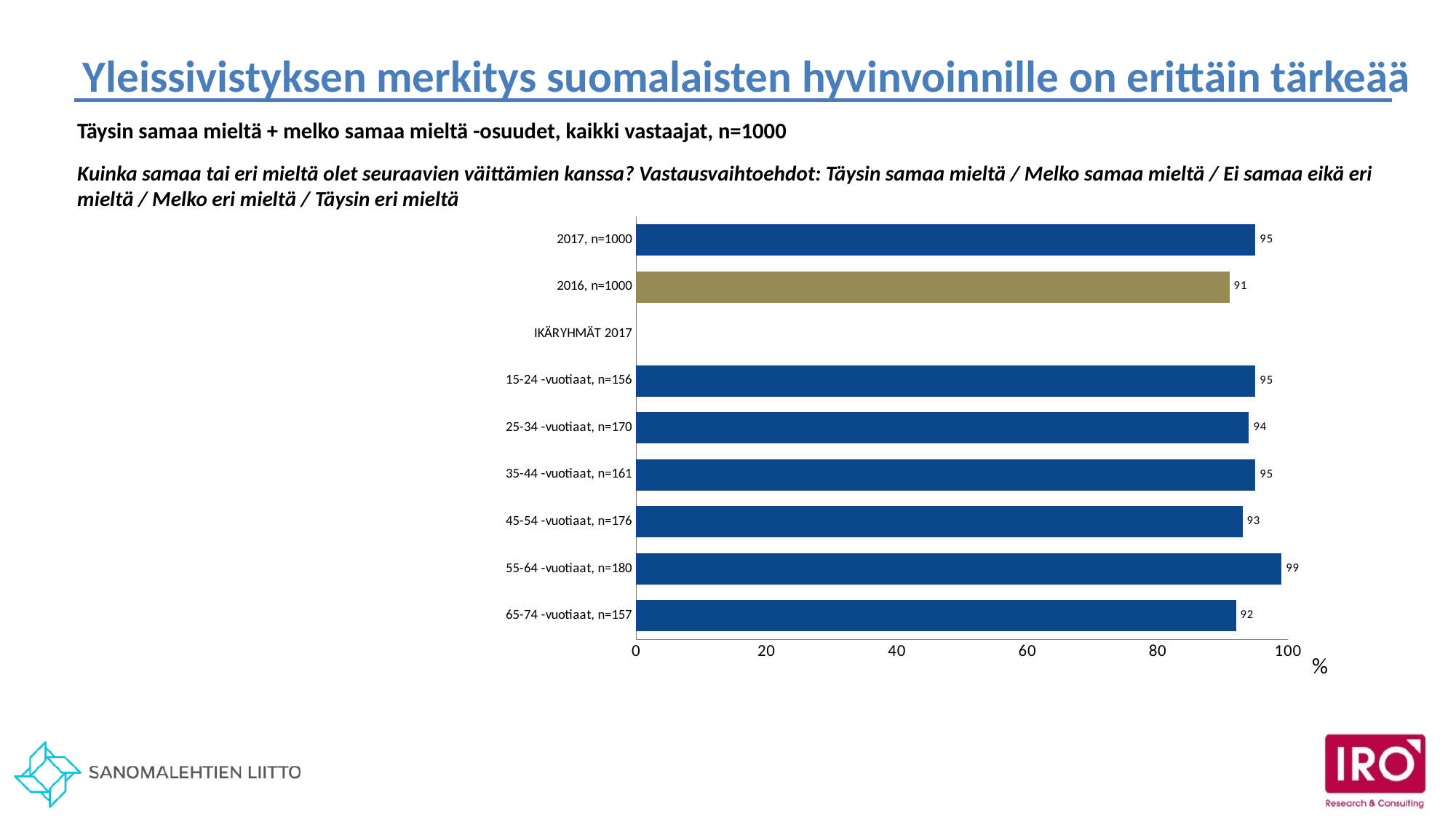
What is the value for 45-54 -vuotiaat, n=176? 93 What is the value for 55-64 -vuotiaat, n=180? 99 What is the value for 2016, n=1000? 91 Which category has the lowest value? 2016, n=1000 Which category has the highest value? 55-64 -vuotiaat, n=180 What kind of chart is shown on the slide? bar chart Which is larger, the value for 25-34 -vuotiaat, n=170 or the value for 65-74 -vuotiaat, n=157? 25-34 -vuotiaat, n=170 Which bar is shown in a different colour from the others? 2016, n=1000 Is the value for 35-44 -vuotiaat, n=161 greater or less than 80? greater What is the value for 2017, n=1000? 95 What is the difference between the values for 55-64 -vuotiaat, n=180 and 65-74 -vuotiaat, n=157? 7 What is the difference between the values for 2017, n=1000 and 2016, n=1000? 4